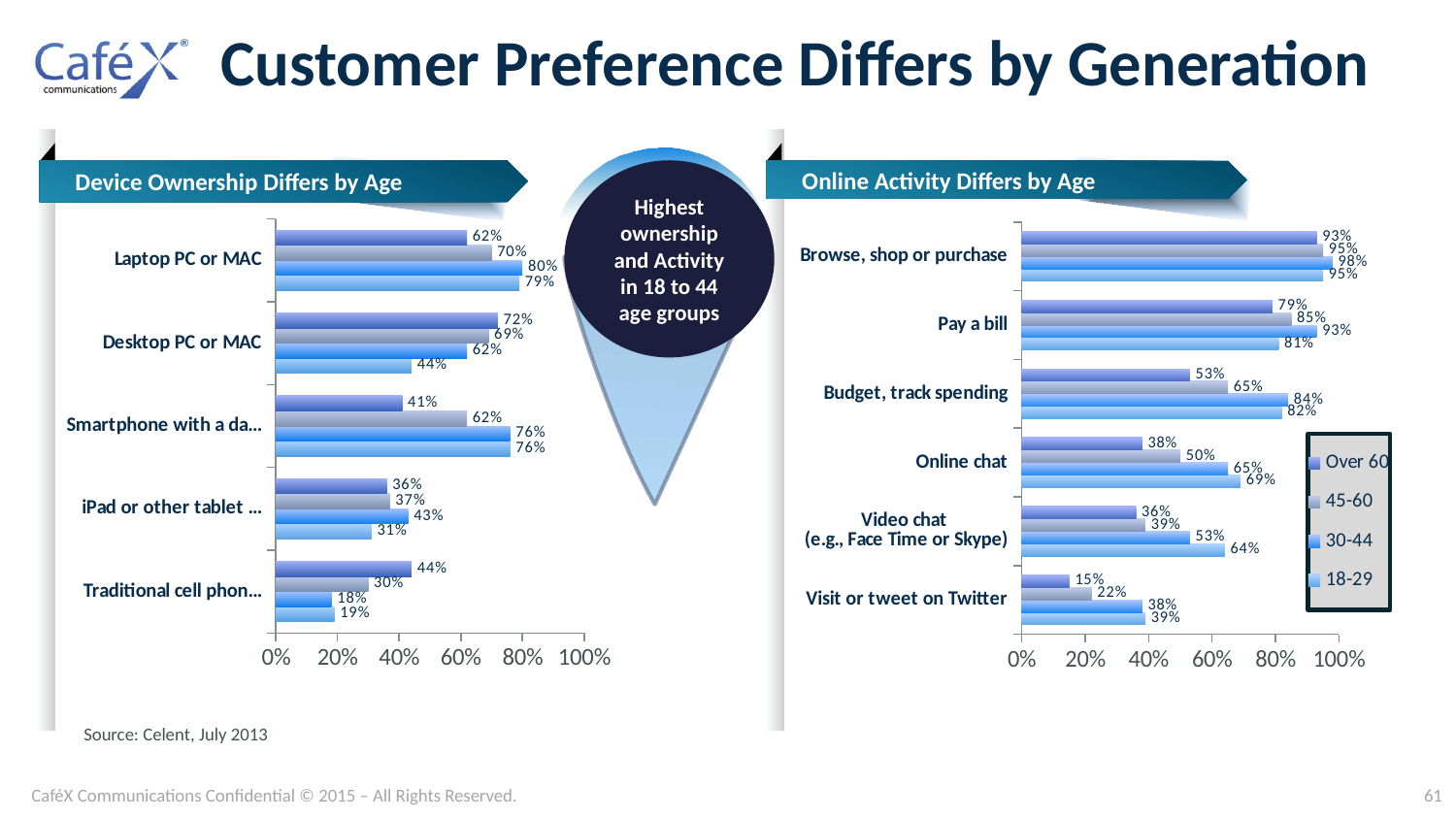
In the 'Online Activity Differs by Age' chart, what is the value for the 30-44 group for 'Pay a bill'? 93% How many activity categories are shown in the 'Online Activity Differs by Age' chart? 6 What type of chart is the 'Device Ownership Differs by Age' chart? bar chart In the 'Online Activity Differs by Age' chart, which age group has the lowest value for 'Budget, track spending'? Over 60 In the 'Device Ownership Differs by Age' chart, what is the lowest value shown for 'Traditional cell phone'? 18% How many age groups does the legend on the 'Online Activity Differs by Age' chart list? 4 In the 'Online Activity Differs by Age' chart, what is the value for the Over 60 group for 'Visit or tweet on Twitter'? 15% In the 'Online Activity Differs by Age' chart, which age group has the highest value for 'Video chat (e.g., Face Time or Skype)'? 18-29 In the 'Online Activity Differs by Age' chart, what is the difference between the 30-44 and Over 60 values for 'Budget, track spending'? 31% In the 'Device Ownership Differs by Age' chart, is the top bar for 'Desktop PC or MAC' (72%) larger or smaller than the top bar for 'Smartphone' (41%)? larger In the 'Device Ownership Differs by Age' chart, what is the highest value shown for 'Laptop PC or MAC'? 80% In the 'Online Activity Differs by Age' chart, what is the value for the 18-29 group for 'Online chat'? 69%